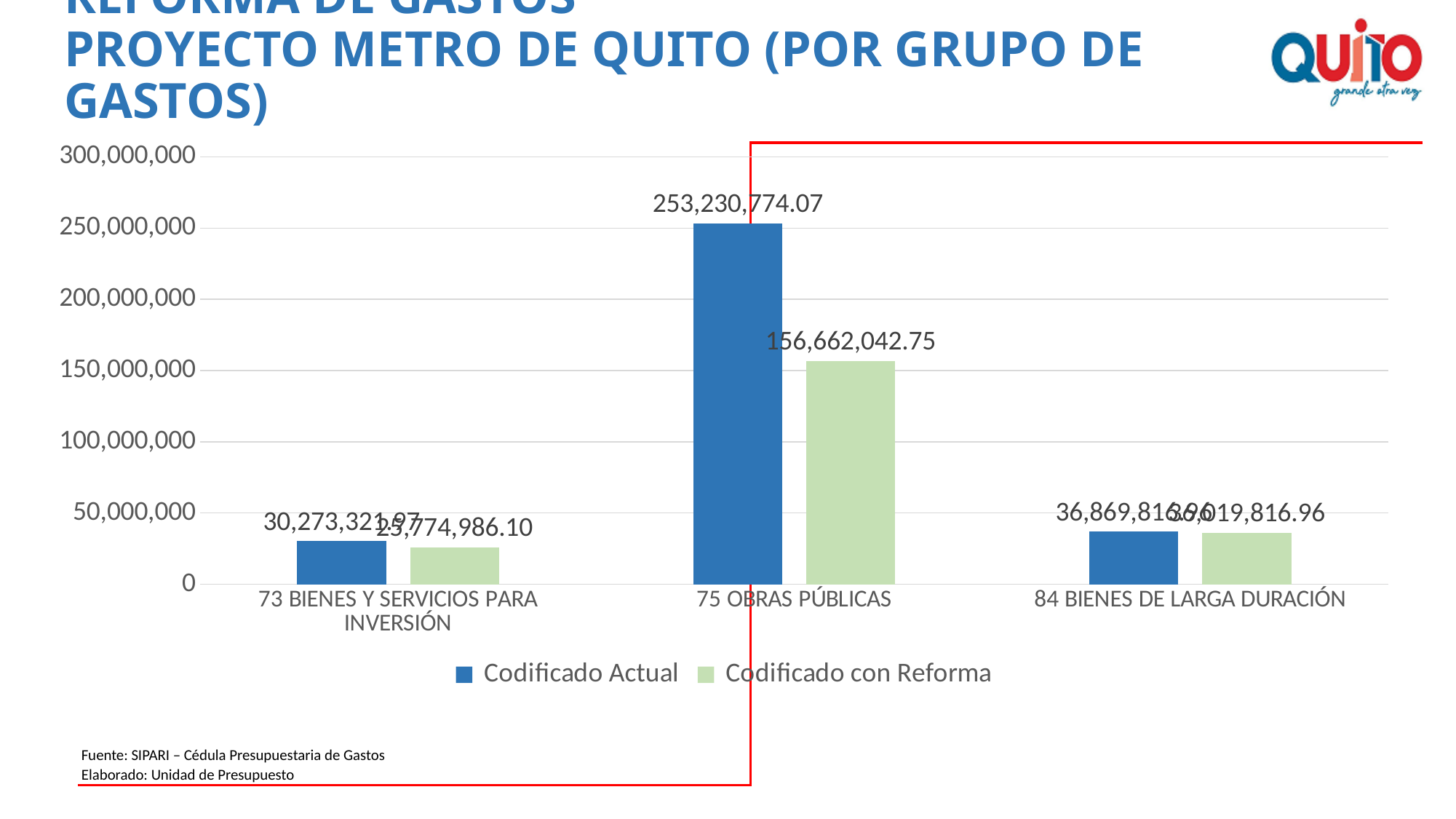
What is the difference between the Codificado Actual and Codificado con Reforma values for 75 OBRAS PÚBLICAS? 96,568,731.32 Which category has the lowest Codificado con Reforma value? 73 BIENES Y SERVICIOS PARA INVERSIÓN Which category has the highest Codificado Actual value? 75 OBRAS PÚBLICAS What is the Codificado Actual value for 75 OBRAS PÚBLICAS? 253,230,774.07 How many expense group categories are shown on the x axis? 3 What is the Codificado con Reforma value for 75 OBRAS PÚBLICAS? 156,662,042.75 Is the Codificado Actual value for 75 OBRAS PÚBLICAS greater or less than 200,000,000? greater What is the Codificado con Reforma value for 73 BIENES Y SERVICIOS PARA INVERSIÓN? 25,774,986.10 How many series does the legend list? 2 What kind of chart is shown on the slide? bar chart Is the Codificado con Reforma value for 84 BIENES DE LARGA DURACIÓN greater or less than 50,000,000? less For 75 OBRAS PÚBLICAS, which is larger: Codificado Actual or Codificado con Reforma? Codificado Actual